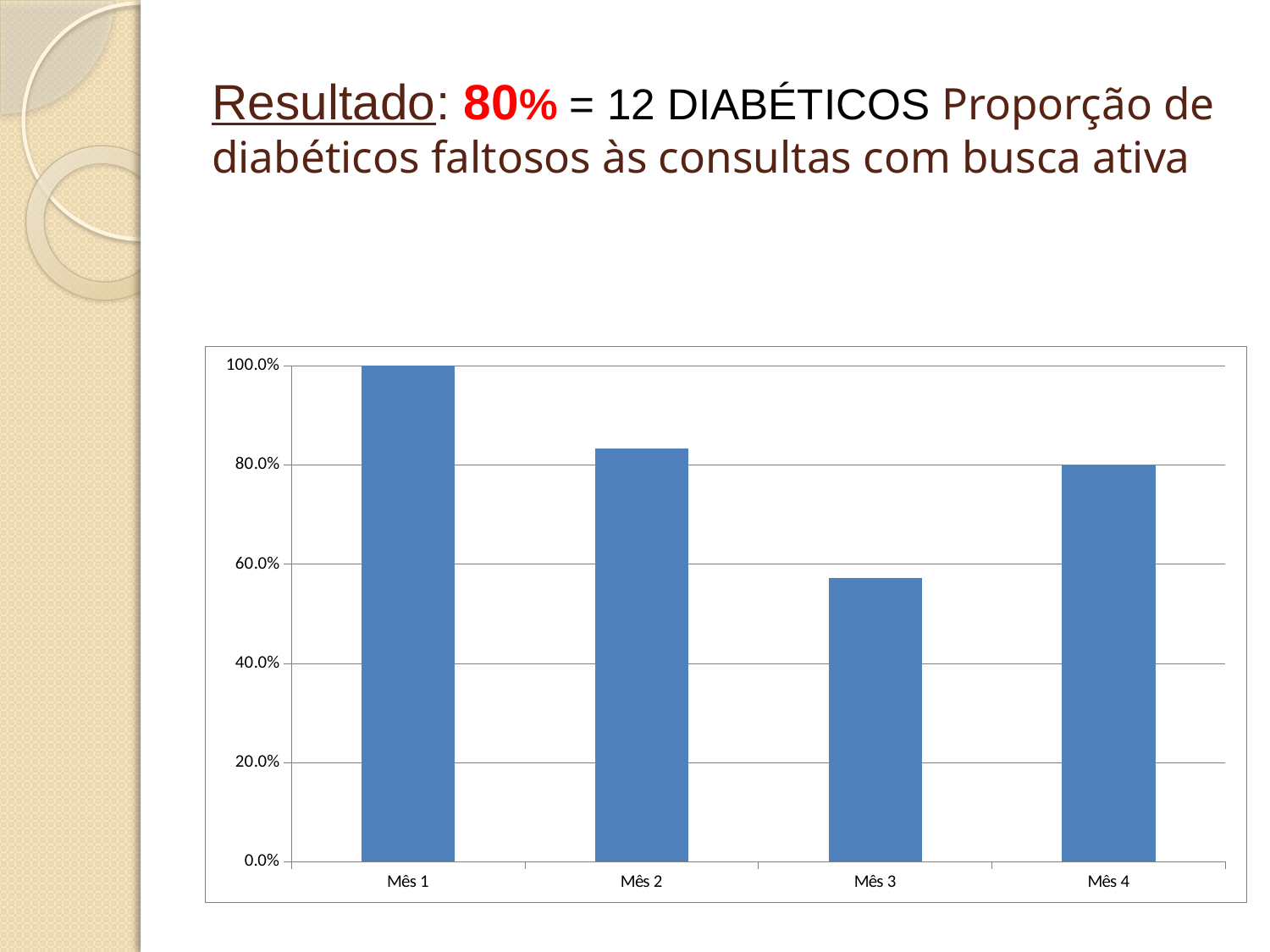
What is the value for Mês 4? 80.0% Which is larger, the value for Mês 2 or the value for Mês 3? Mês 2 Which month has the highest bar? Mês 1 What is the value for Mês 1? 100.0% How many months (categories) are plotted on the x axis? 4 Do the values rise or fall from Mês 1 to Mês 3? fall Is the value for Mês 3 greater or less than 60.0%? less Which month has the lowest bar? Mês 3 Is the value for Mês 2 greater or less than 100.0%? less What is the highest value shown on the y axis? 100.0% What kind of chart is shown on the slide? bar chart Is the value for Mês 3 greater or less than 40.0%? greater